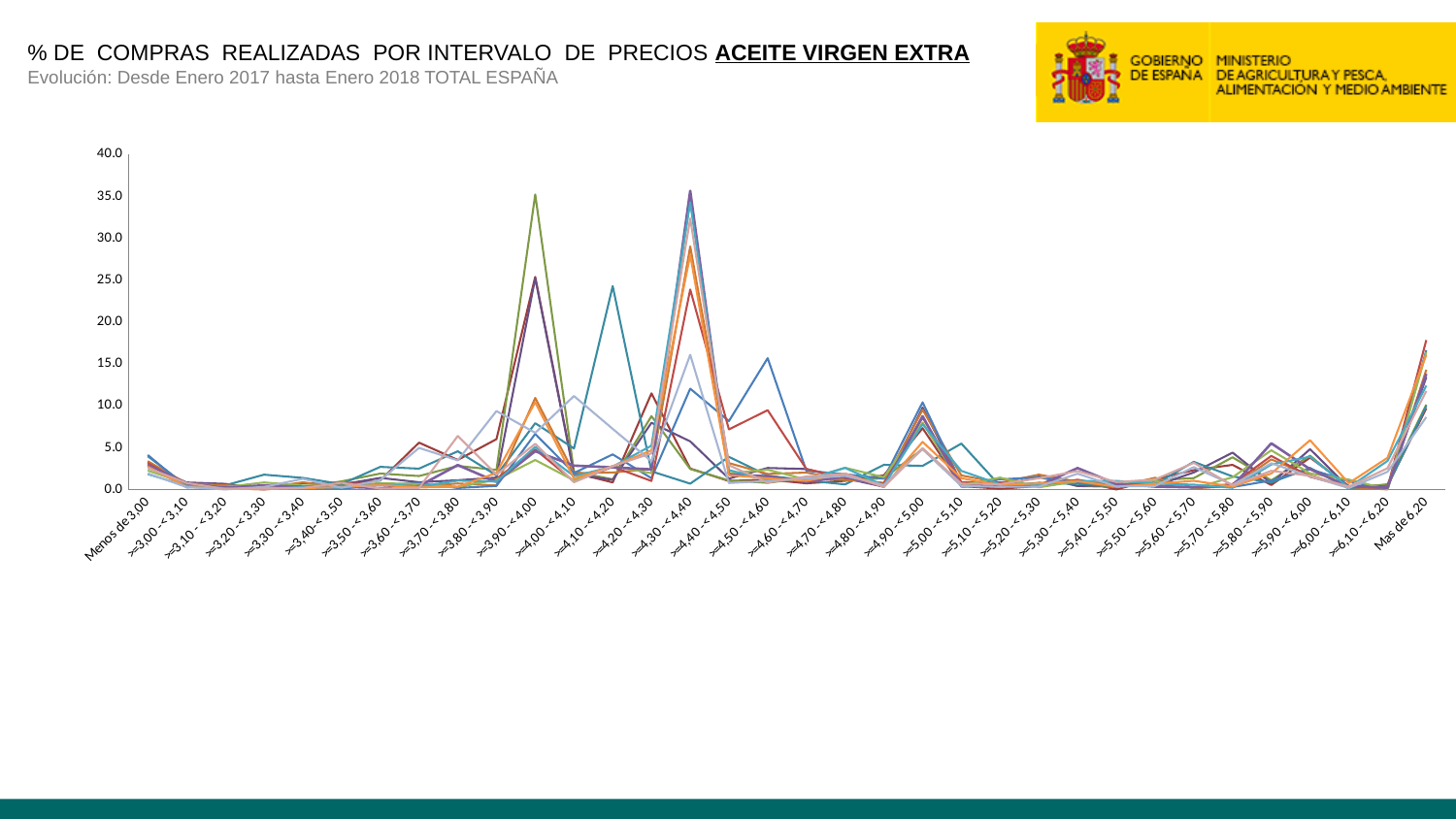
What is the label of the first category on the x axis? Menos de 3,00 Is the highest value of any line at the category >=4,90 - <5,00 greater or less than 15? less Is the highest value of any line at the category >=4,10 - <4,20 greater or less than 20? greater Is the highest value of any line at the category >=3,00 - <3,10 greater or less than 5? less How many price-interval categories are shown along the x axis of the chart? 34 What is the title of the chart on the slide? % DE COMPRAS REALIZADAS POR INTERVALO DE PRECIOS ACEITE VIRGEN EXTRA What is the highest value shown on the y axis of the chart? 40.0 What is the label of the last category on the x axis? Mas de 6,20 What kind of chart is shown on the slide? line chart